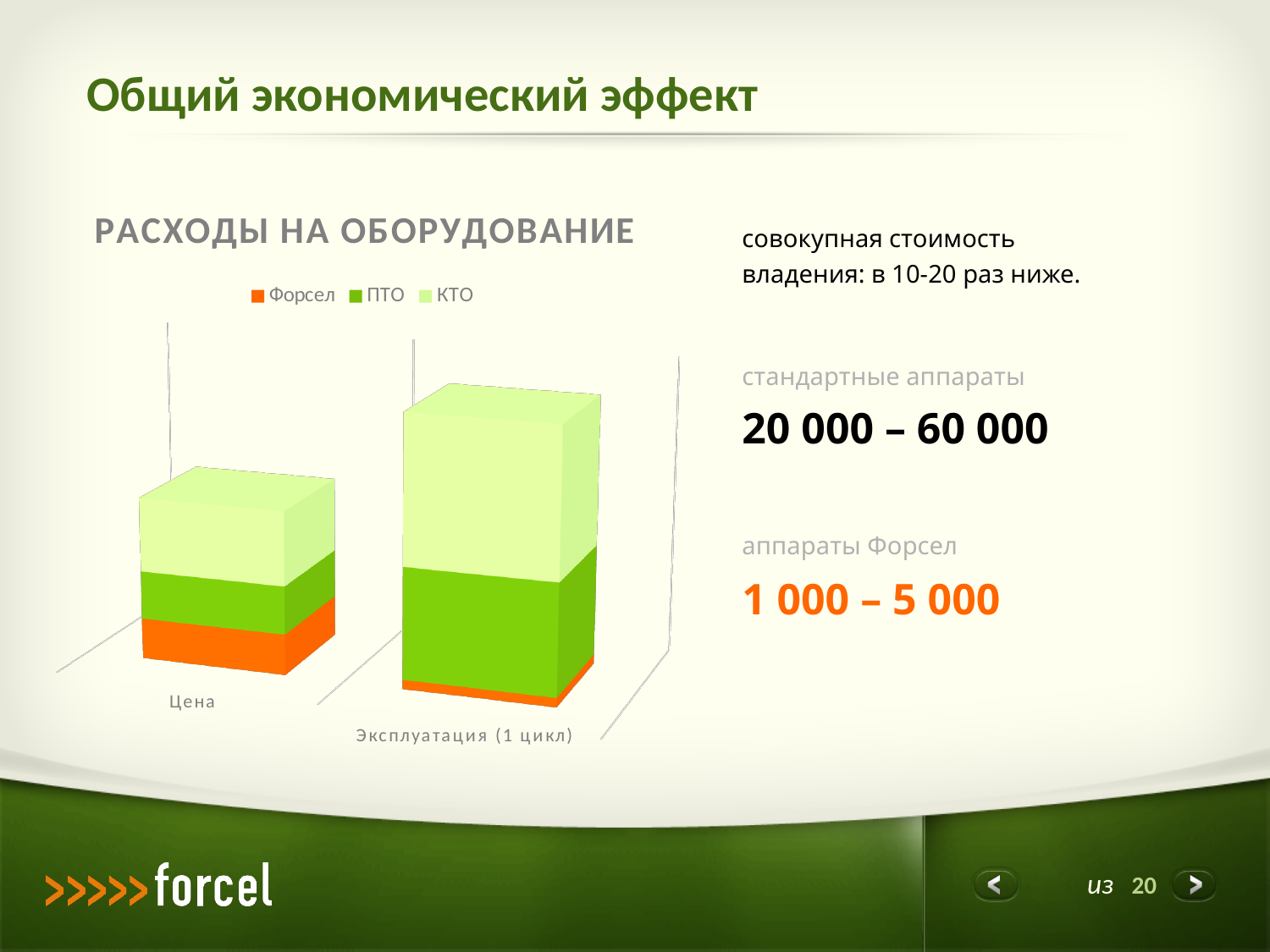
Which stacked bar is taller, Цена or Эксплуатация (1 цикл)? Эксплуатация (1 цикл) How many categories are shown on the x axis of the chart? 2 Do the stacked bar totals rise or fall from Цена to Эксплуатация (1 цикл)? Rise What is the title of the chart? РАСХОДЫ НА ОБОРУДОВАНИЕ Which series is the smallest segment in the Эксплуатация (1 цикл) bar? Форсел Which category has the shortest stacked bar? Цена What kind of chart is shown on the slide? Stacked bar chart How many series does the chart legend list? 3 In the Эксплуатация (1 цикл) bar, which segment is larger, Форсел or ПТО? ПТО Which series are listed in the chart legend? Форсел, ПТО, КТО In the Цена bar, which segment is larger, КТО or Форсел? КТО Which category has the tallest stacked bar? Эксплуатация (1 цикл)